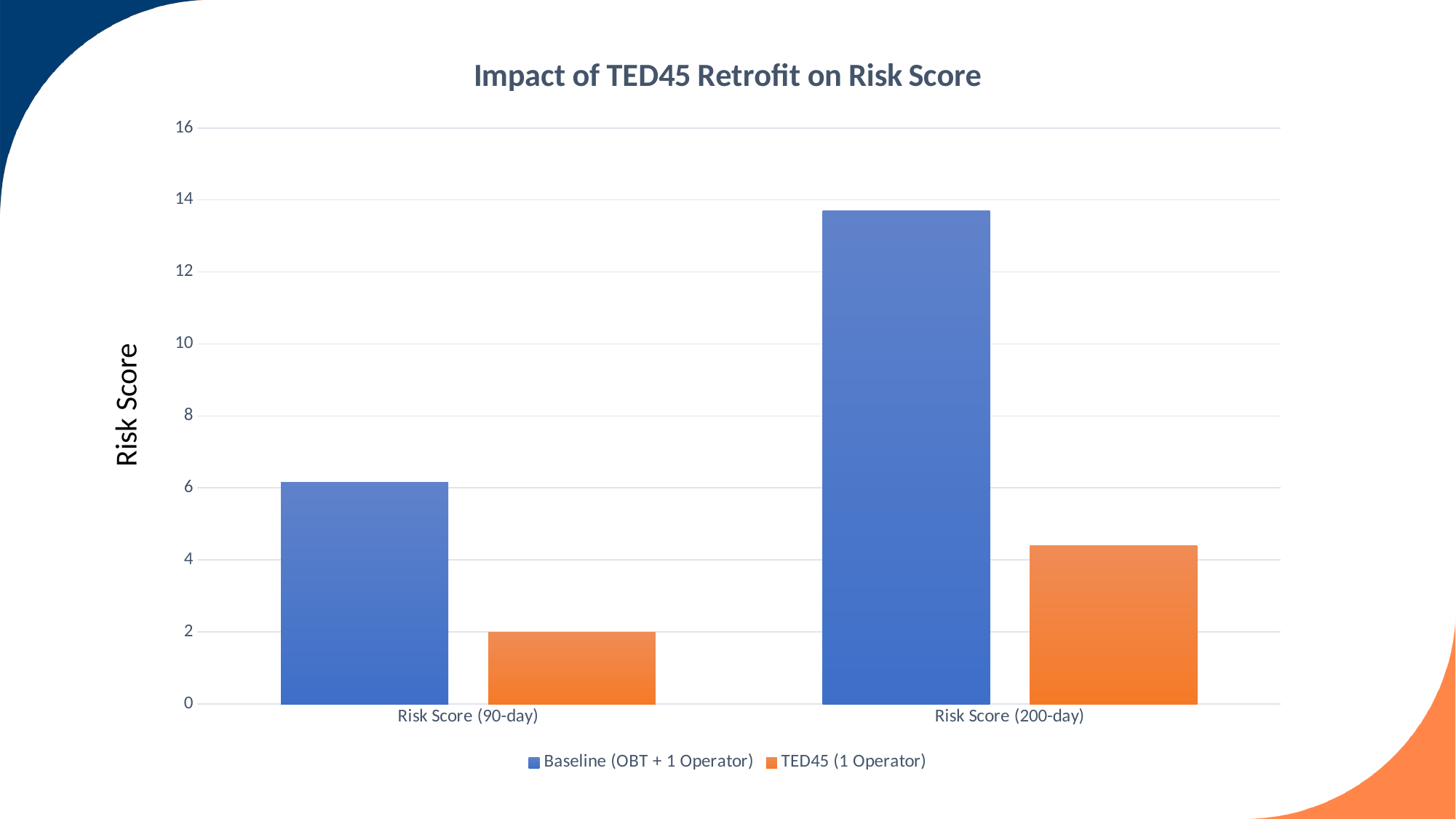
What is the title of the chart? Impact of TED45 Retrofit on Risk Score What is the label on the vertical axis? Risk Score How many categories are shown on the x axis? 2 Is the TED45 (1 Operator) value for Risk Score (200-day) greater or less than 6? less Is the Baseline (OBT + 1 Operator) value for Risk Score (200-day) greater or less than 12? greater Which bar is the tallest in the chart? Baseline (OBT + 1 Operator) for Risk Score (200-day) For Risk Score (90-day), which series has the larger value, Baseline (OBT + 1 Operator) or TED45 (1 Operator)? Baseline (OBT + 1 Operator) How many series does the legend list? 2 Which bar is the shortest in the chart? TED45 (1 Operator) for Risk Score (90-day) For Risk Score (200-day), which series has the larger value, Baseline (OBT + 1 Operator) or TED45 (1 Operator)? Baseline (OBT + 1 Operator) Is the Baseline (OBT + 1 Operator) value for Risk Score (90-day) greater or less than 8? less What kind of chart is shown on the slide? bar chart